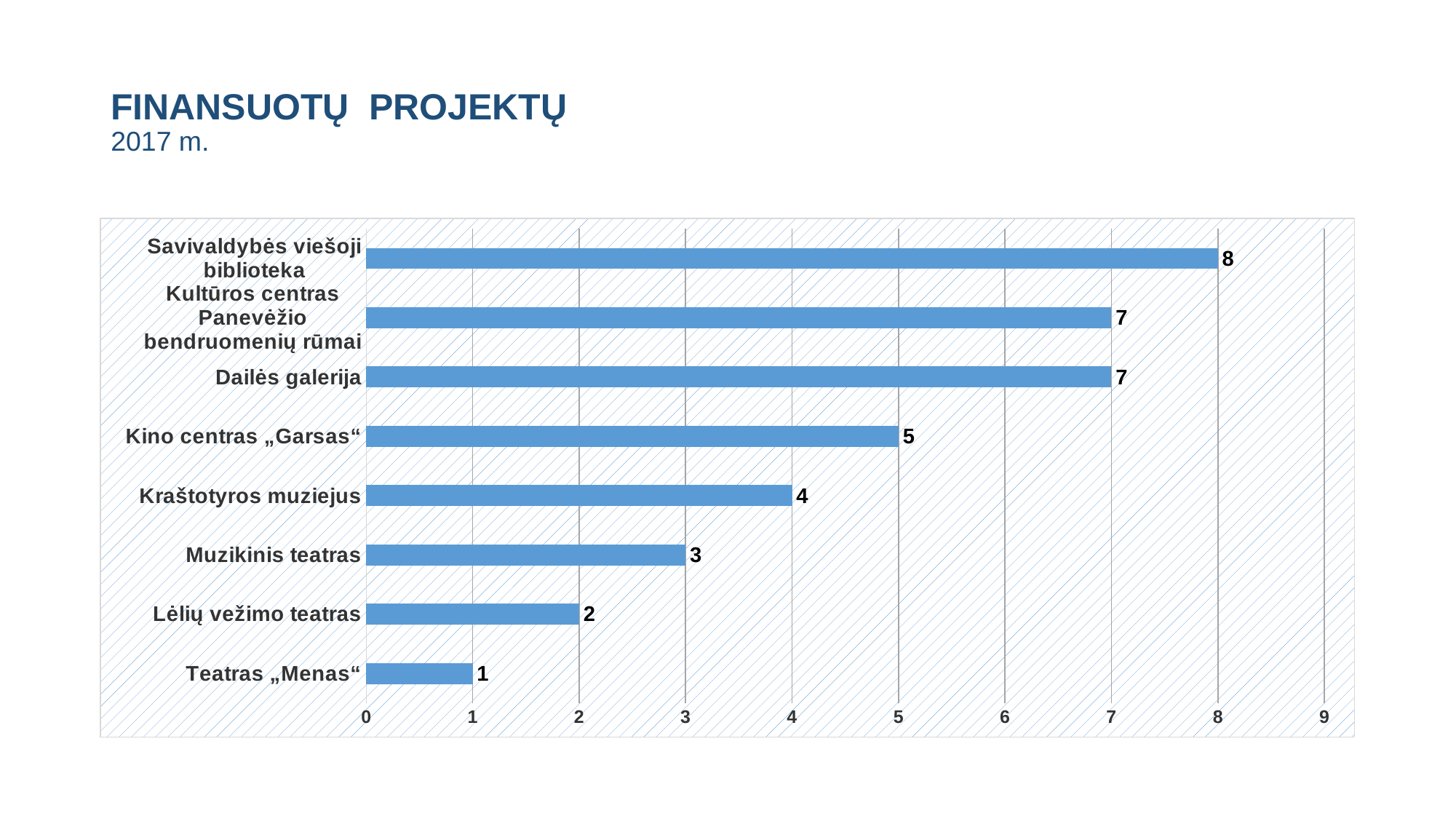
What is the value for Lėlių vežimo teatras? 2 How many categories are shown in the chart? 8 What is the difference between the values for Savivaldybės viešoji biblioteka and Muzikinis teatras? 5 Which is larger, the value for Dailės galerija or the value for Kraštotyros muziejus? Dailės galerija What is the title of the slide? FINANSUOTŲ PROJEKTŲ 2017 m. Which category has the highest value? Savivaldybės viešoji biblioteka What kind of chart is shown on the slide? bar chart What is the value for Kino centras „Garsas“? 5 Which category has the lowest value? Teatras „Menas“ What is the value for Savivaldybės viešoji biblioteka? 8 What is the value for Kraštotyros muziejus? 4 What is the difference between the values for Kino centras „Garsas“ and Lėlių vežimo teatras? 3